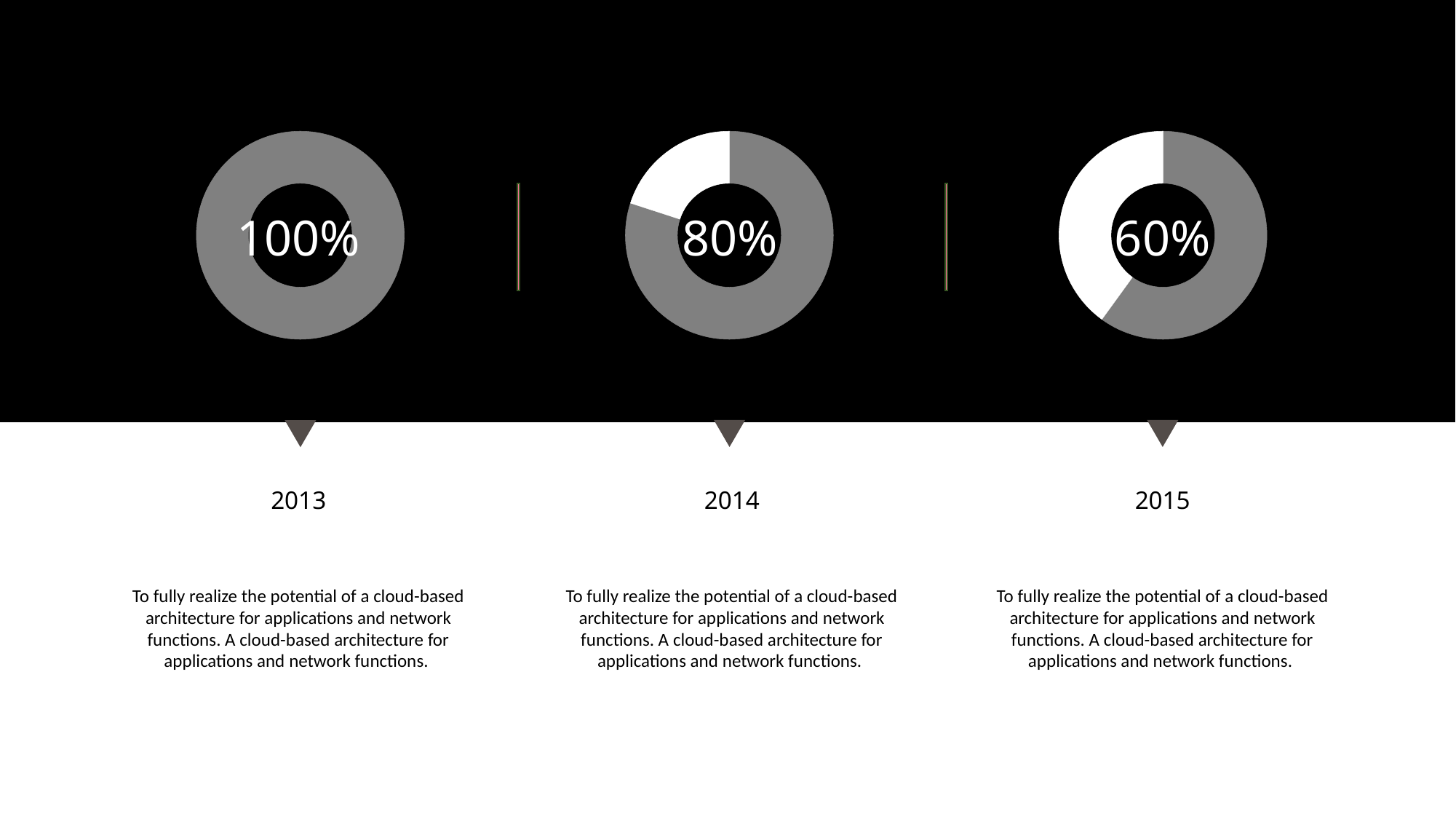
How many donut charts are on the slide? 3 What percentage is shown in the donut chart for 2013? 100% Do the percentages rise or fall from 2013 to 2015? Fall What is the difference between the percentage shown for 2014 and the percentage shown for 2015? 20% Which is larger, the percentage shown for 2014 or the percentage shown for 2015? 2014 What colour is the filled portion of the donut charts? Grey What is the difference between the percentage shown for 2013 and the percentage shown for 2015? 40% What kind of chart is used to show the percentage for each year? Donut chart Which year's donut chart shows the highest percentage? 2013 What percentage is shown in the donut chart for 2014? 80% What percentage is shown in the donut chart for 2015? 60% Which year's donut chart shows the lowest percentage? 2015